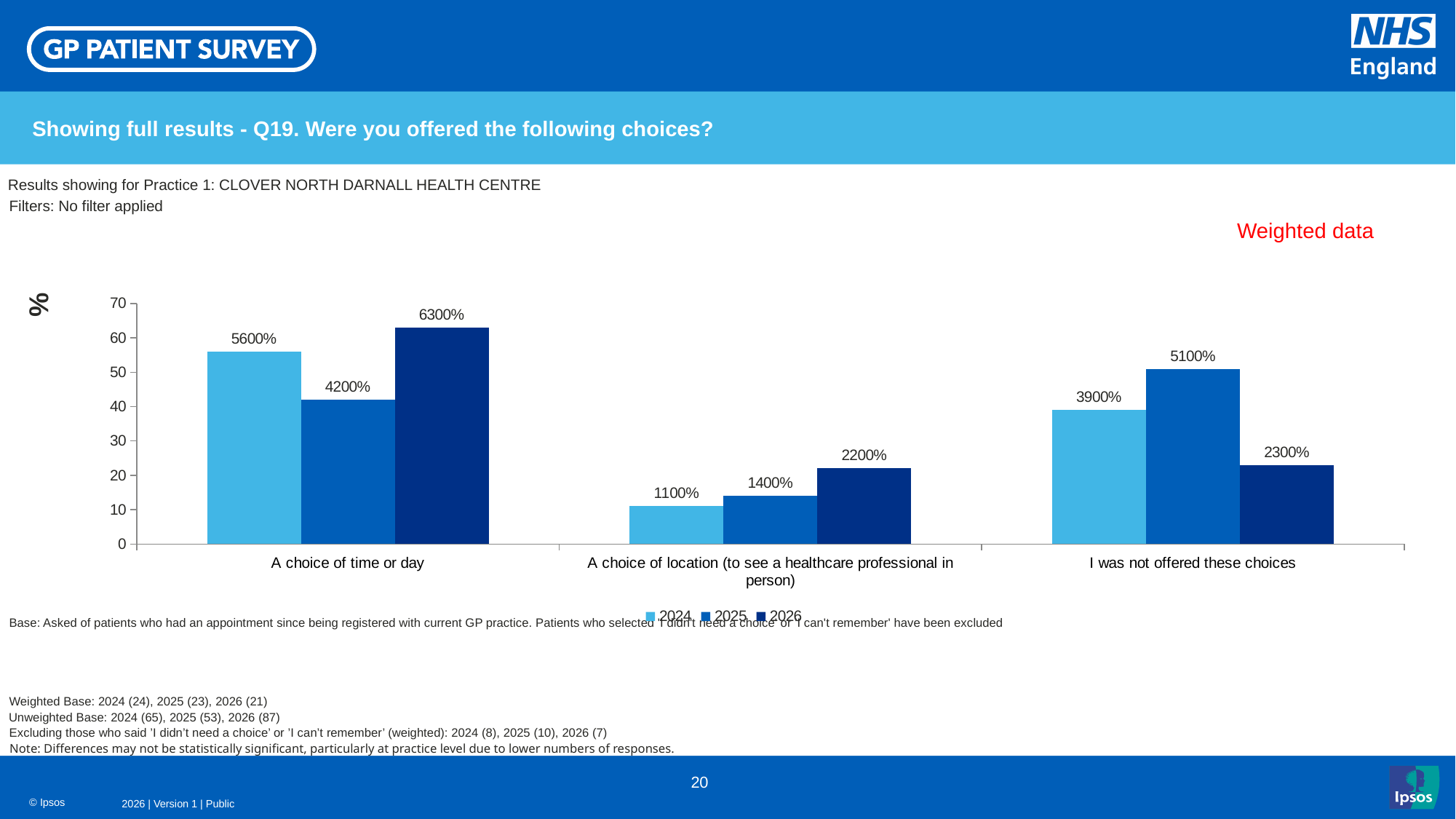
What is the difference between the 2026 and 2024 values in the 'A choice of time or day' category? 700% Which year has the highest value in the 'A choice of time or day' category? 2026 How many categories are shown on the x axis? 3 What is the value for 2025 in the 'I was not offered these choices' category? 5100% Which category has the lowest 2024 value? A choice of location (to see a healthcare professional in person) What kind of chart is shown on the slide? Bar chart Which year has the lowest value in the 'I was not offered these choices' category? 2026 Is the 2025 value for 'A choice of time or day' larger or smaller than the 2025 value for 'I was not offered these choices'? smaller Do the values for 'A choice of location (to see a healthcare professional in person)' rise or fall from 2024 to 2026? rise What is the value for 2026 in the 'A choice of time or day' category? 6300% How many series does the legend list? 3 What is the value for 2024 in the 'A choice of location (to see a healthcare professional in person)' category? 1100%